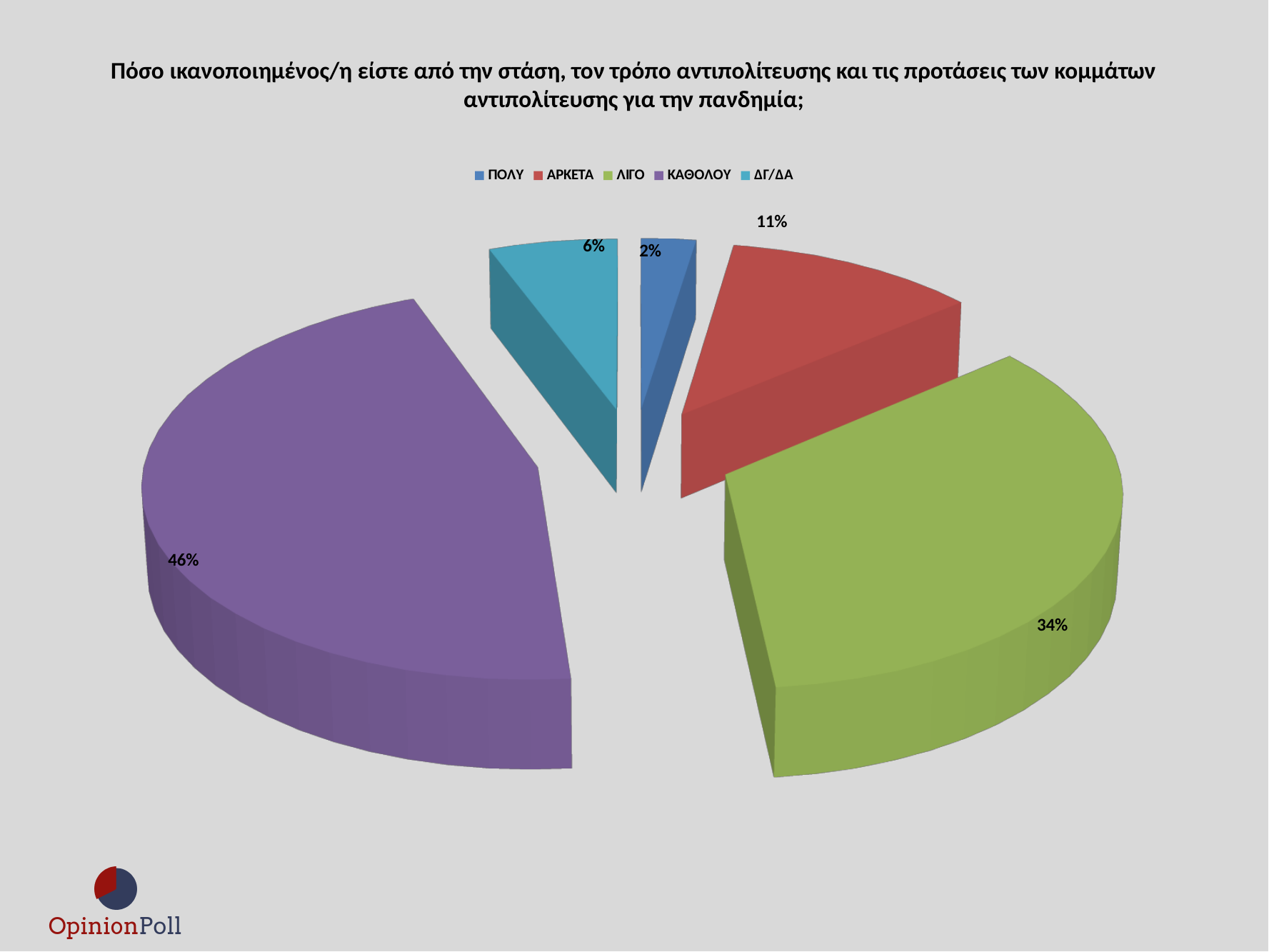
Which category has the smallest slice of the pie? ΠΟΛΥ What kind of chart is shown on the slide? pie chart Which is larger, the slice for ΑΡΚΕΤΑ or the slice for ΔΓ/ΔΑ? ΑΡΚΕΤΑ Which category has the largest slice of the pie? ΚΑΘΟΛΟΥ What is the difference in percentage points between ΚΑΘΟΛΟΥ and ΛΙΓΟ? 12 What percentage is shown for ΑΡΚΕΤΑ? 11% What percentage is shown for ΛΙΓΟ? 34% What percentage is shown for ΔΓ/ΔΑ? 6% What percentage is shown for ΚΑΘΟΛΟΥ? 46% What colour is the slice for ΛΙΓΟ? green What percentage is shown for ΠΟΛΥ? 2% How many categories does the legend list? 5